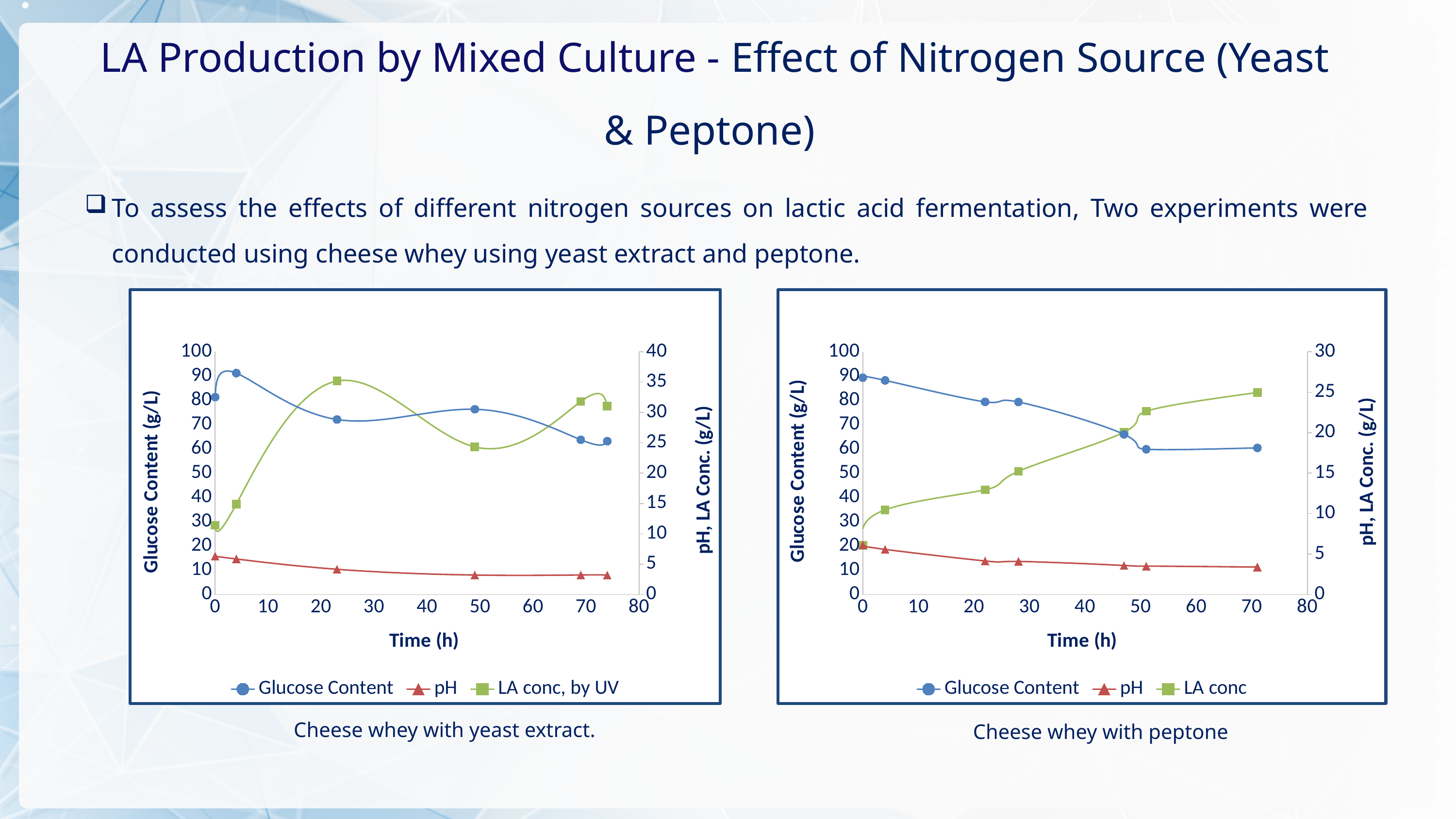
How many series does the legend of the left chart (Cheese whey with yeast extract) list? 3 In the left chart (Cheese whey with yeast extract), which is larger: the LA conc, by UV value at about 23 h or at about 49 h? at about 23 h In the right chart (Cheese whey with peptone), is the Glucose Content value at about 71 h greater or less than 70? less How many data points are plotted for the LA conc, by UV series in the left chart (Cheese whey with yeast extract)? 6 In the right chart (Cheese whey with peptone), is the LA conc value at about 71 h greater or less than 20 on the right axis? greater In the right chart (Cheese whey with peptone), does Glucose Content rise or fall over time? fall In the right chart (Cheese whey with peptone), what are the three series named in the legend? Glucose Content, pH, LA conc In the left chart (Cheese whey with yeast extract), is the LA conc, by UV value at about 23 h greater or less than 30 on the right axis? greater How many data points are plotted for the Glucose Content series in the right chart (Cheese whey with peptone)? 7 What kind of chart is the 'Cheese whey with yeast extract' chart on the left? line chart In the right chart (Cheese whey with peptone), does LA conc rise or fall over time? rise